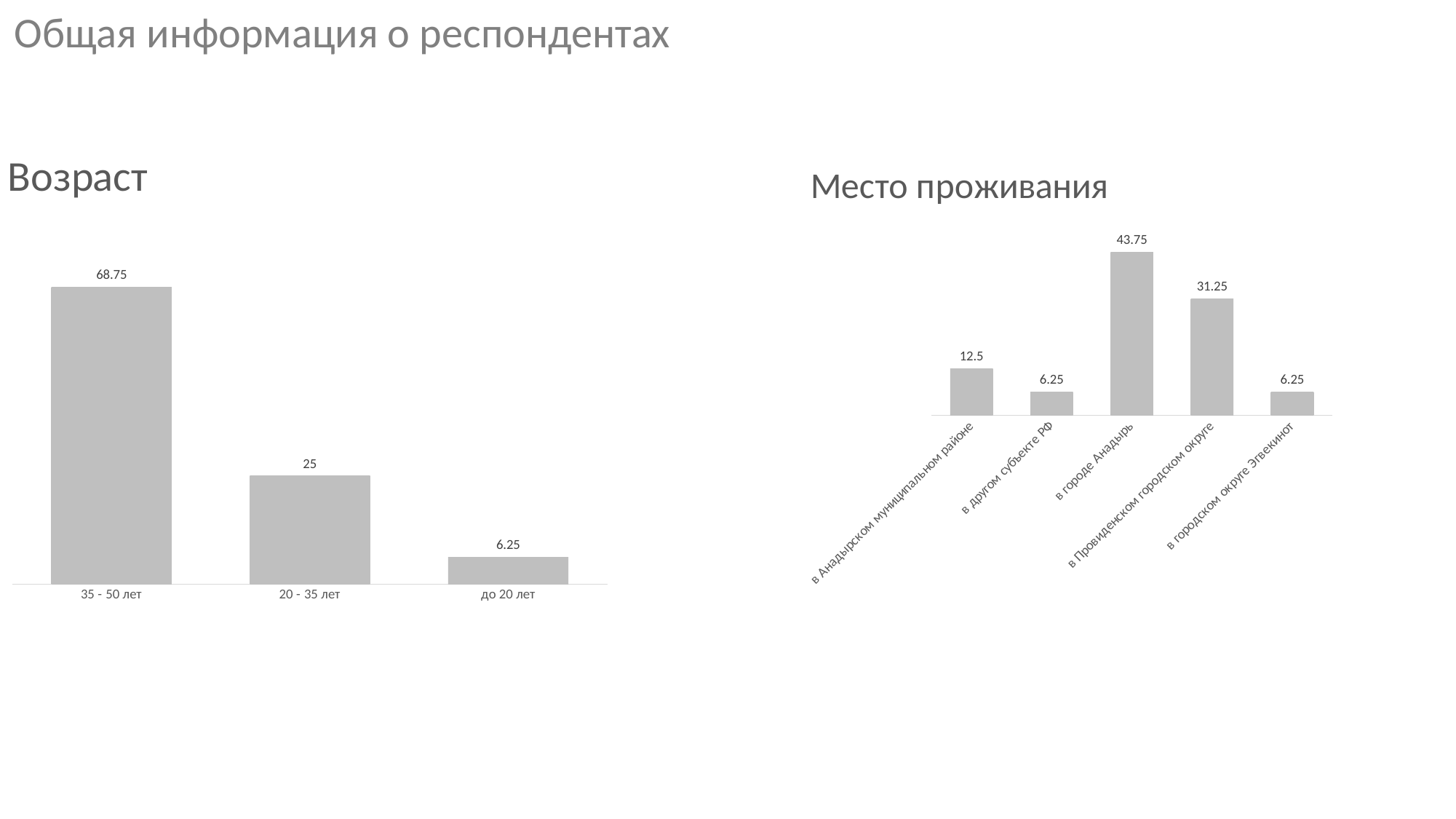
In the "Место проживания" chart, what is the value for "в Анадырском муниципальном районе"? 12.5 In the "Возраст" chart, what is the difference between the values for "35 - 50 лет" and "20 - 35 лет"? 43.75 In the "Возраст" chart, what is the value for "35 - 50 лет"? 68.75 What type of chart is the "Место проживания" chart? bar chart In the "Место проживания" chart, what is the difference between the values for "в городе Анадырь" and "в Провиденском городском округе"? 12.5 In the "Возраст" chart, how many categories are shown? 3 In the "Место проживания" chart, which is larger: the value for "в Провиденском городском округе" or for "в Анадырском муниципальном районе"? в Провиденском городском округе In the "Возраст" chart, which category has the highest value? 35 - 50 лет In the "Место проживания" chart, which category has the highest value? в городе Анадырь In the "Место проживания" chart, what is the value for "в городе Анадырь"? 43.75 In the "Возраст" chart, do the values rise or fall from left to right? fall In the "Возраст" chart, what is the value for "до 20 лет"? 6.25